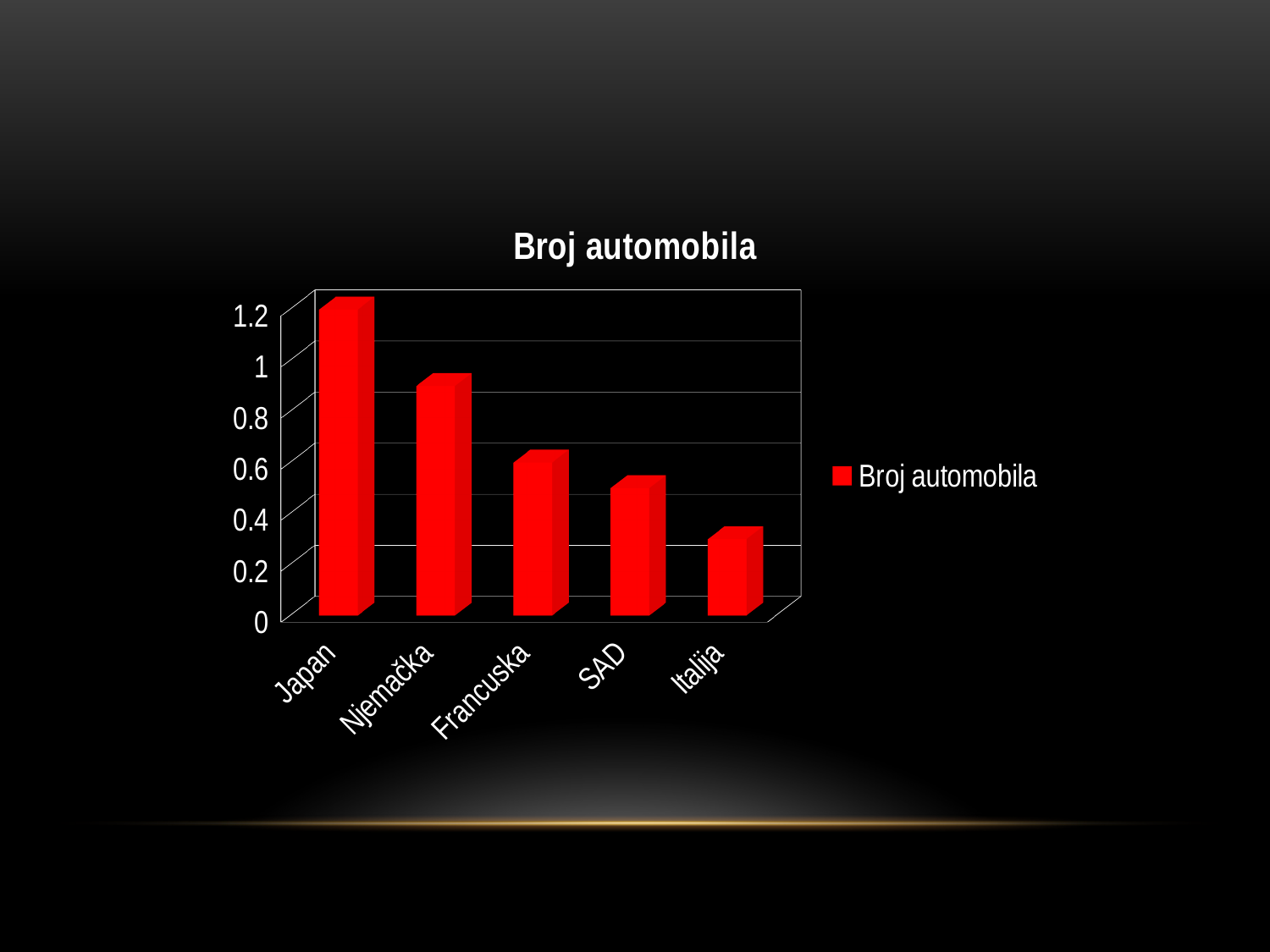
What type of chart is shown on the slide? bar chart How many series does the legend list? 1 Is the value for Italija greater or less than 0.4? less What is the title of the chart? Broj automobila How many categories are shown on the x axis of the chart? 5 Is the value for Francuska greater or less than 0.8? less Which category has the lowest value in the chart? Italija Is the value for Japan greater or less than 1? greater Which category has the highest value in the chart? Japan Do the values rise or fall from left to right along the x axis? fall Which has a larger value, Njemačka or SAD? Njemačka